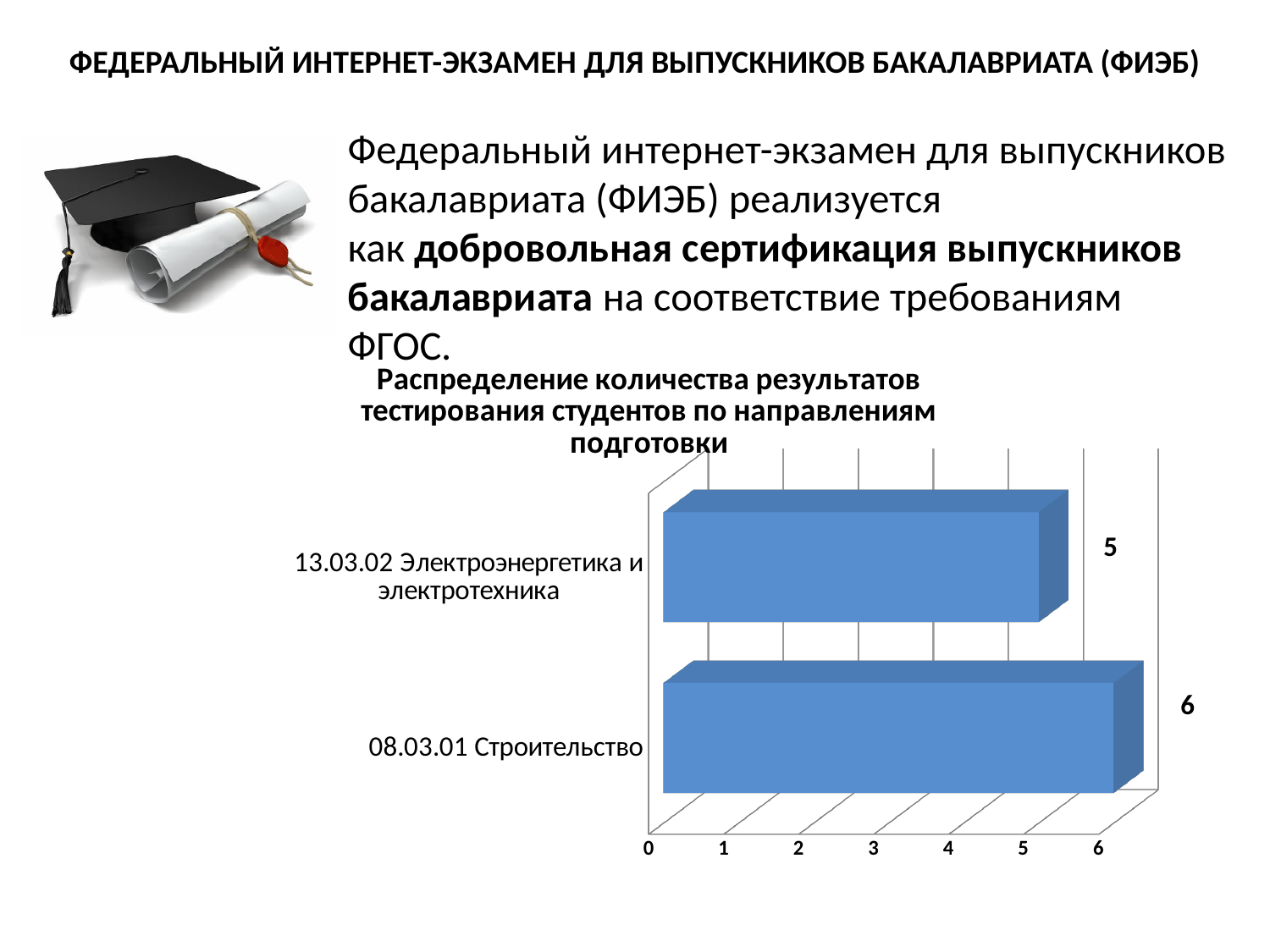
What is the title of the chart? Распределение количества результатов тестирования студентов по направлениям подготовки What is the difference between the values for 08.03.01 Строительство and 13.03.02 Электроэнергетика и электротехника? 1 What is the maximum value shown on the chart's axis? 6 What kind of chart is shown on the slide? bar chart Which category has the lowest value? 13.03.02 Электроэнергетика и электротехника What is the value for 08.03.01 Строительство? 6 How many categories are shown in the chart? 2 What is the value for 13.03.02 Электроэнергетика и электротехника? 5 Is the value for 13.03.02 Электроэнергетика и электротехника greater or less than 4? greater Which is larger: the value for 08.03.01 Строительство or for 13.03.02 Электроэнергетика и электротехника? 08.03.01 Строительство Which category has the highest value? 08.03.01 Строительство